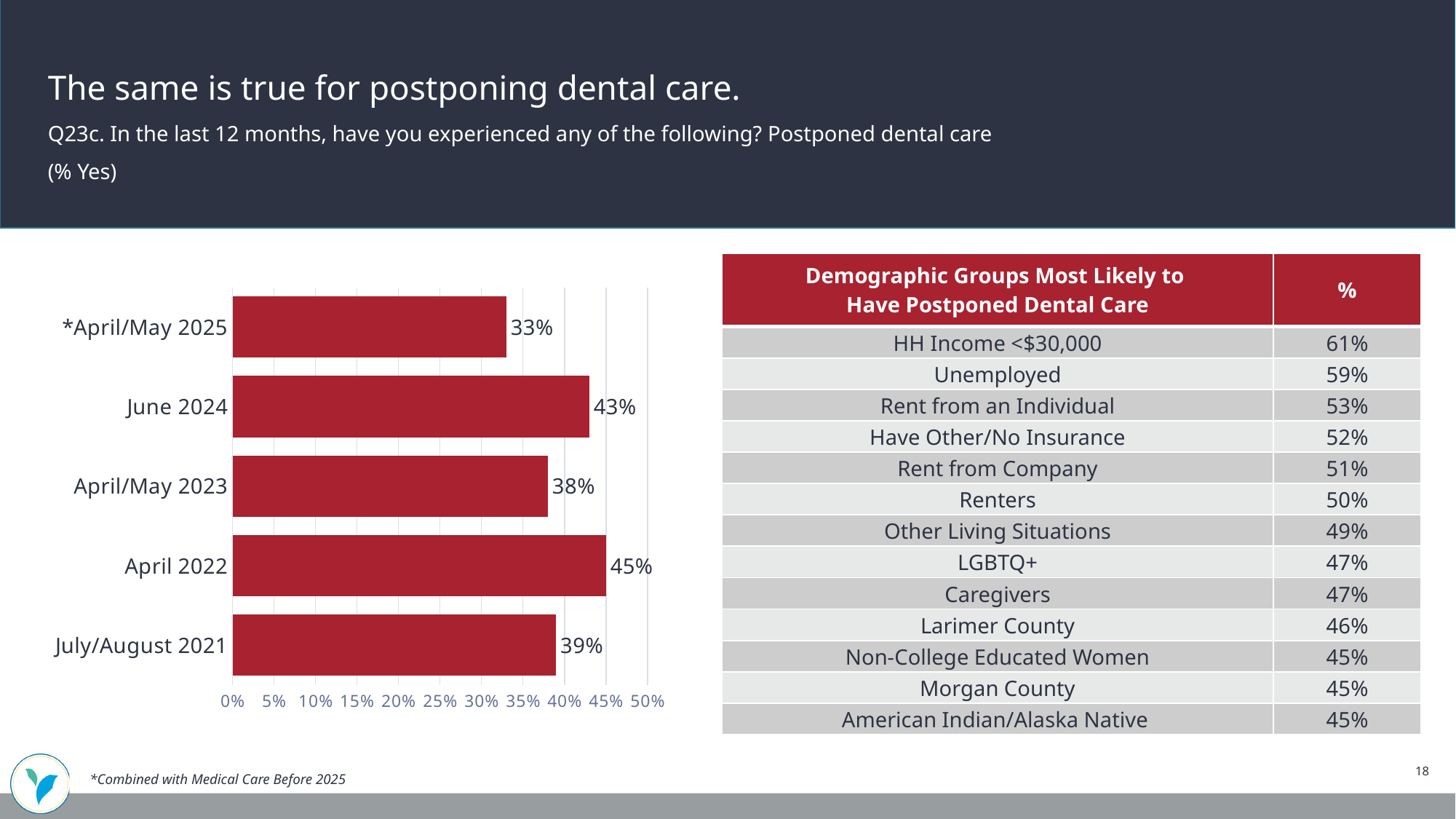
How many survey periods are shown in the bar chart? 5 What is the value shown for July/August 2021? 39% What is the difference between the June 2024 value and the April/May 2025 value? 10 percentage points What is the value shown for June 2024? 43% Which survey period has the lowest percentage of respondents who postponed dental care? *April/May 2025 Which survey period has the highest percentage of respondents who postponed dental care? April 2022 What colour are the bars in the chart? Red What is the highest value on the horizontal axis of the bar chart? 50% What percentage postponed dental care in April/May 2025? 33% Is the value for April 2022 greater or less than 40%? greater What kind of chart is used to show the survey results by period? Bar chart Which is larger, the value for April/May 2023 or the value for July/August 2021? July/August 2021